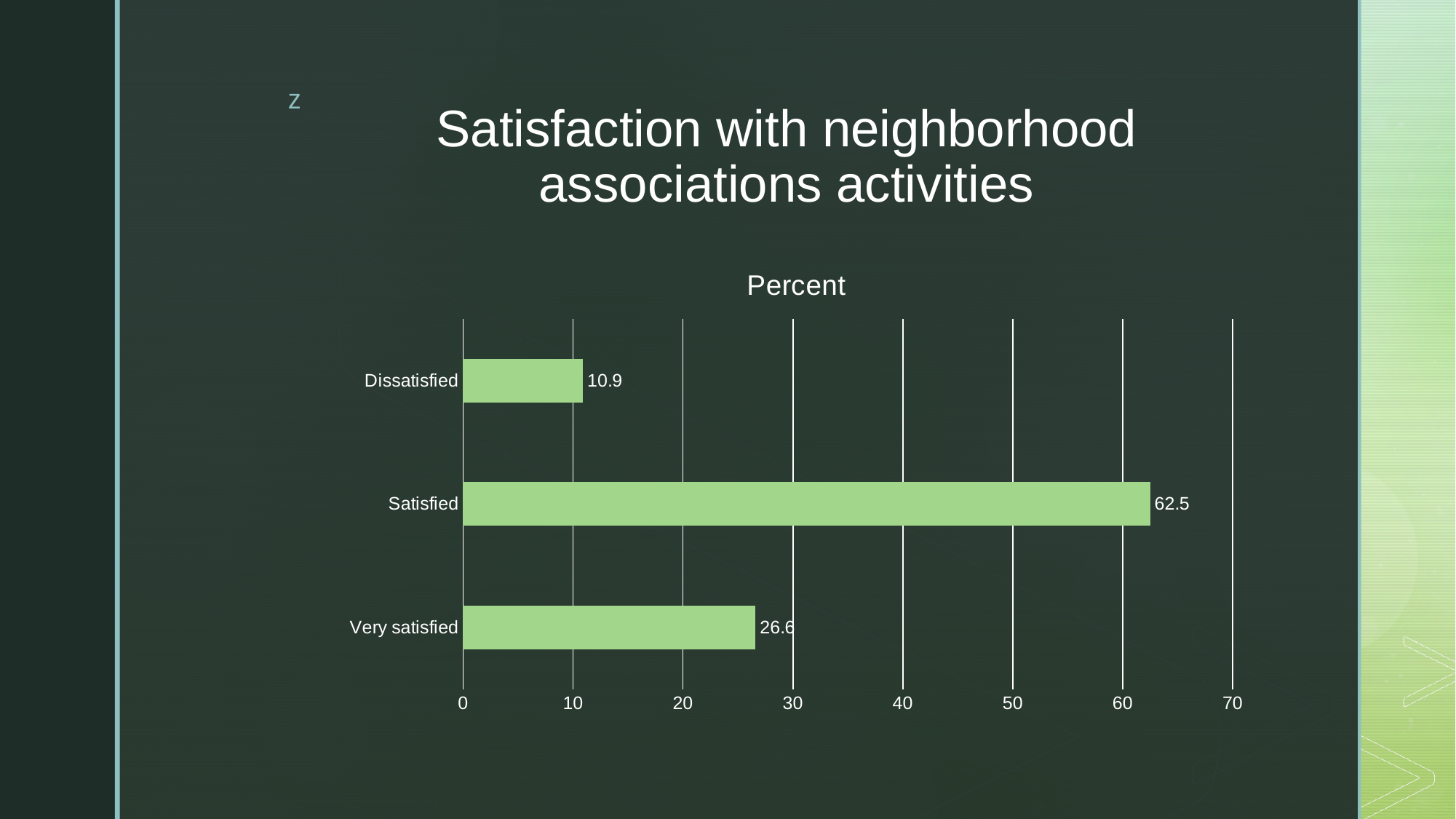
What is the difference between the percent for Satisfied and Very satisfied? 35.9 What is the percent value for Satisfied? 62.5 Which category has the lowest percent? Dissatisfied What is the difference between the percent for Very satisfied and Dissatisfied? 15.7 What is the title of the chart? Percent Which is larger, the percent for Very satisfied or for Dissatisfied? Very satisfied How many categories are shown in the chart? 3 What is the percent value for Very satisfied? 26.6 What is the percent value for Dissatisfied? 10.9 Is the value for Satisfied greater or less than 60? greater What kind of chart is shown on the slide? bar chart Which category has the highest percent? Satisfied